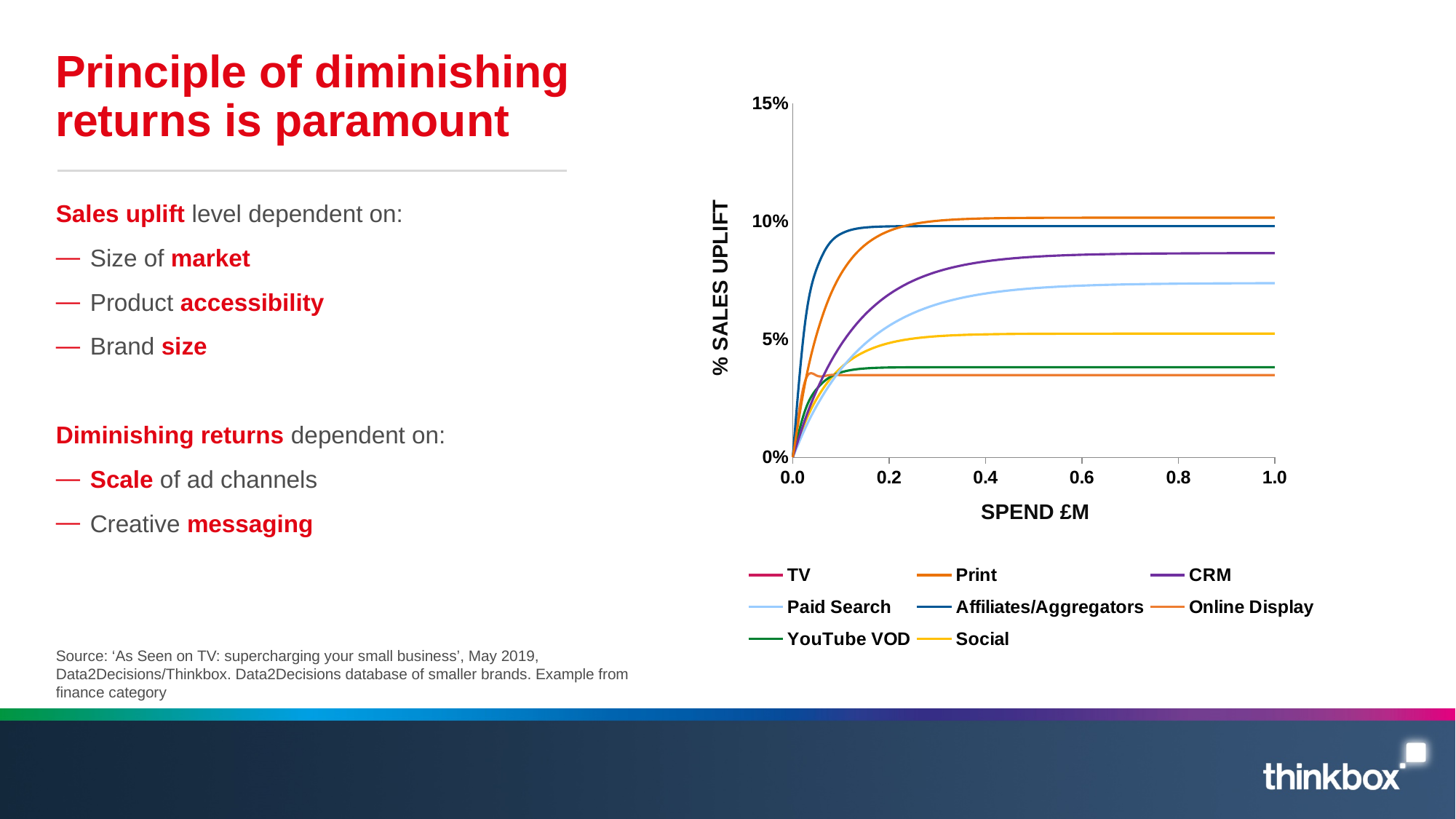
Is the value for CRM at a spend of 1.0 greater or less than 10%? less Is the value for Paid Search at a spend of 1.0 greater or less than 5%? greater Is the value for Social at a spend of 1.0 greater or less than 10%? less Do the sales uplift curves generally rise or fall as spend increases along the x axis? rise At a spend of 1.0, which is larger: CRM or Paid Search? CRM How many series does the chart legend list? 8 What kind of chart is shown on the slide? Line chart What is the label of the horizontal axis of the chart? SPEND £M What is the label of the vertical axis of the chart? % SALES UPLIFT At a spend of 1.0, which is larger: Affiliates/Aggregators or Social? Affiliates/Aggregators